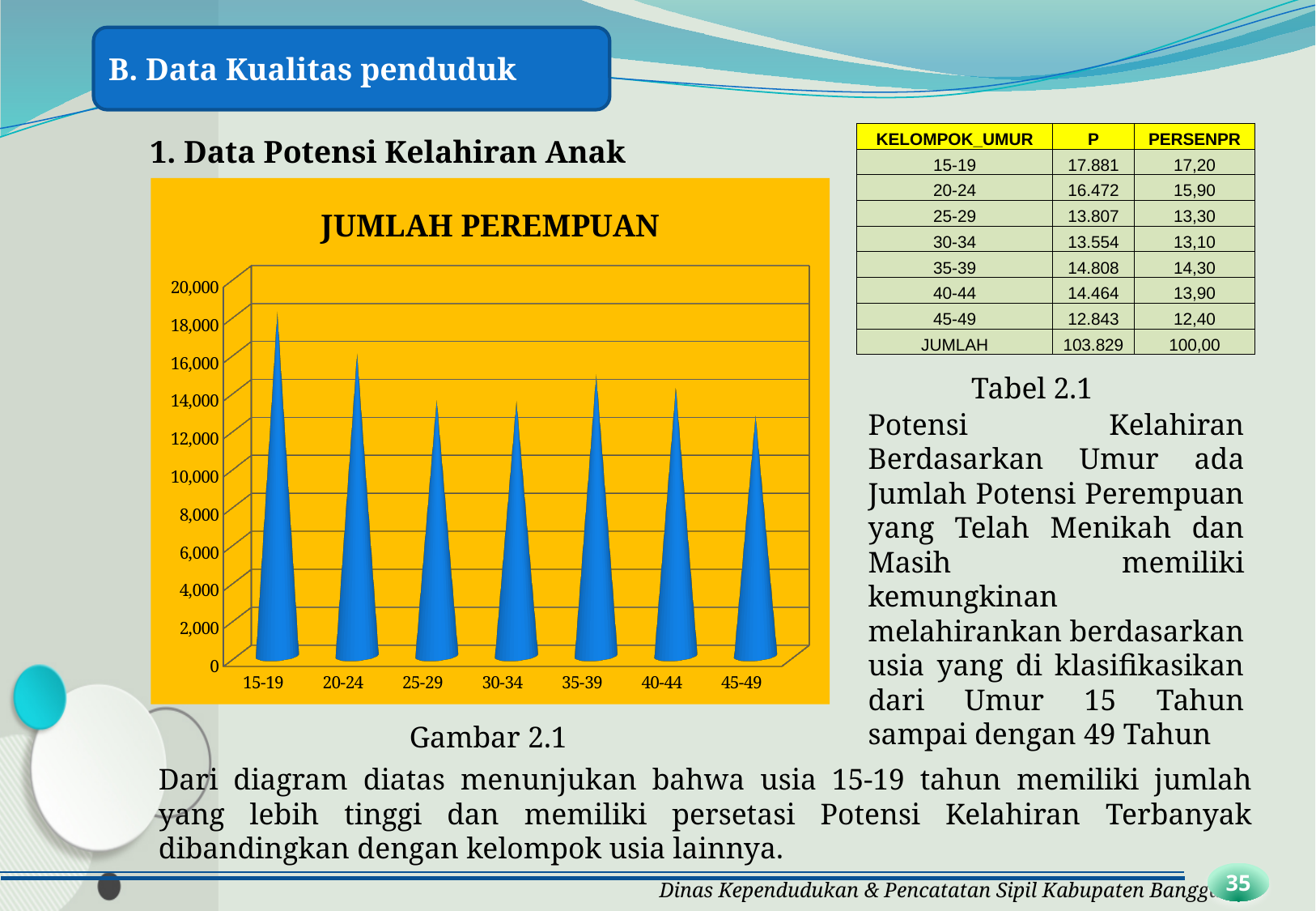
Which age group has the lowest value in the chart? 45-49 Is the value for 15-19 greater or less than 16,000? greater What is the title of the chart? JUMLAH PEREMPUAN Is the value for 45-49 greater or less than 14,000? less Which age group has the highest value in the chart? 15-19 Which is larger, the value for 15-19 or the value for 20-24? 15-19 Is the value for 20-24 greater or less than 14,000? greater What kind of chart is shown under the title JUMLAH PEREMPUAN? bar chart Which is larger, the value for 35-39 or the value for 25-29? 35-39 How many age-group categories are plotted on the x axis of the chart? 7 Do the values generally rise or fall from the 15-19 group to the 45-49 group? fall